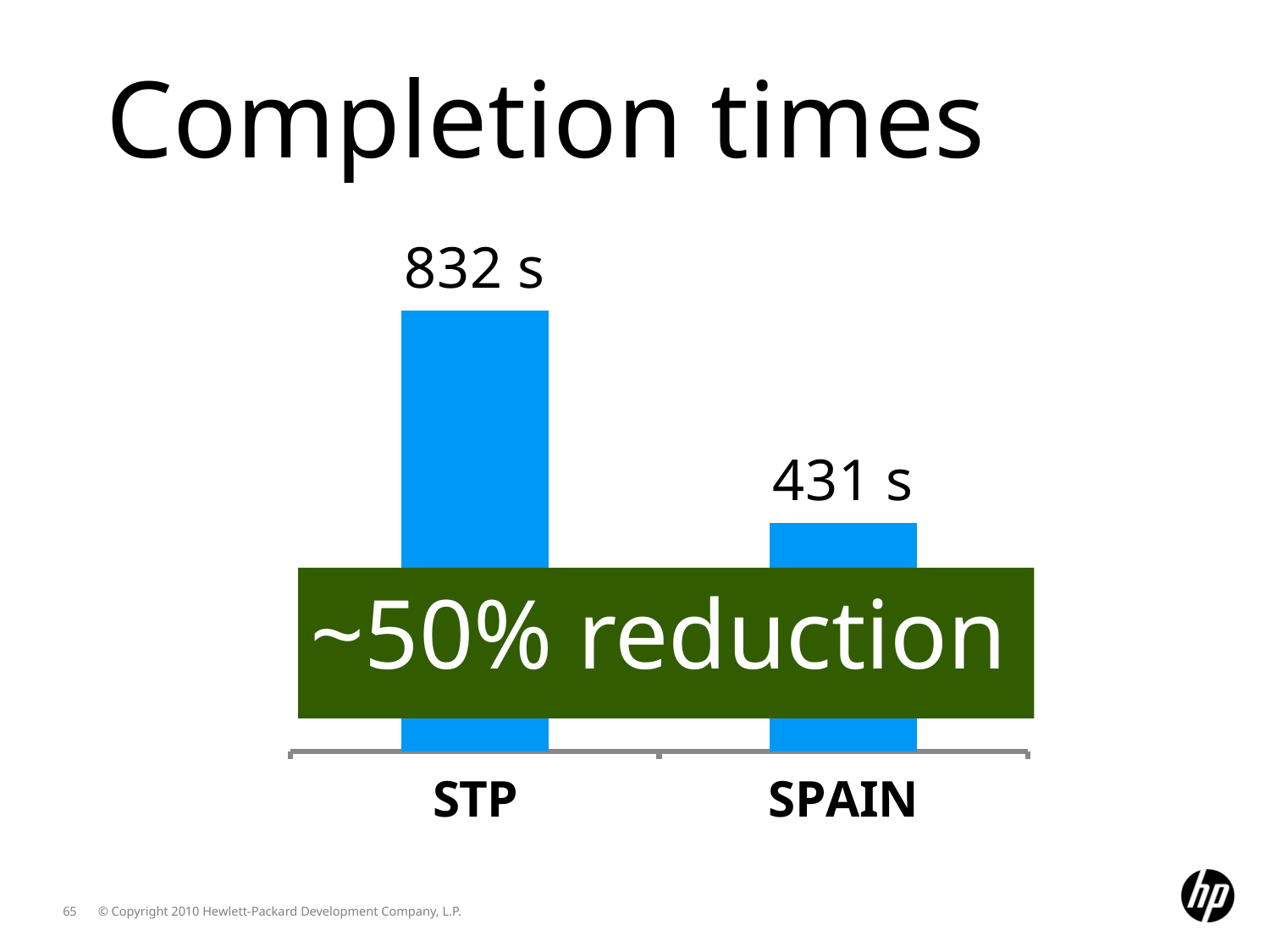
Which category has the highest completion time? STP What is the completion time for STP? 832 s Which category has the lowest completion time? SPAIN What is the title of the slide containing the chart? Completion times Which has a larger completion time, STP or SPAIN? STP What is the completion time for SPAIN? 431 s What kind of chart is shown on the slide? Bar chart What is the difference in completion time between STP and SPAIN? 401 s Do the values rise or fall from STP to SPAIN? Fall How many categories are shown in the chart? 2 What does the green banner overlaid on the chart say? ~50% reduction